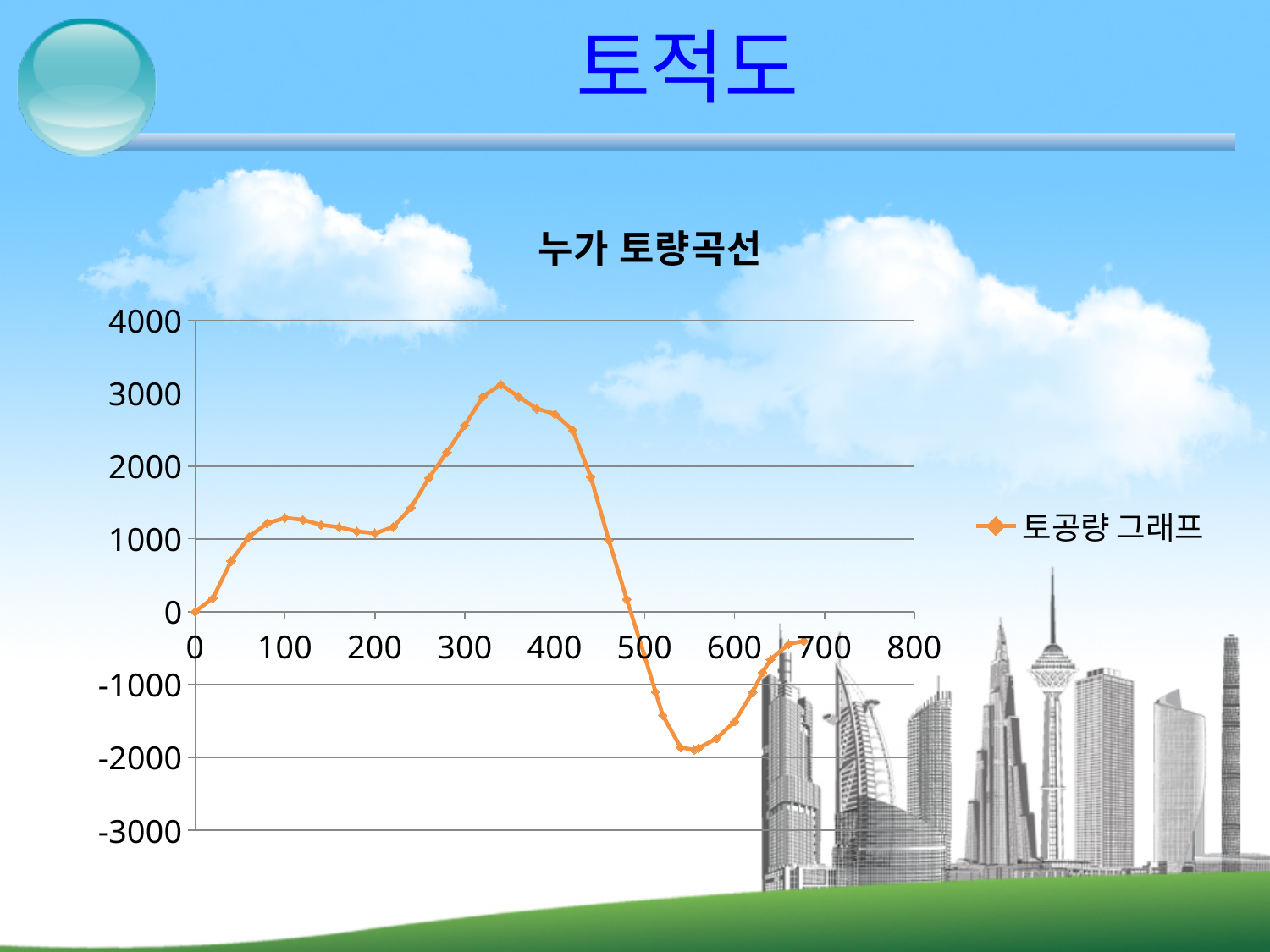
Is the value of the 토공량 그래프 series at x = 600 greater or less than -1000? less Is the value of the 토공량 그래프 series at x = 300 greater or less than 2000? greater What is the value of the 토공량 그래프 series at x = 0? 0 What kind of chart is shown on the slide? line chart Does the 토공량 그래프 series rise or fall between x = 400 and x = 550? fall What is the title of the chart? 누가 토량곡선 How many series does the legend list? 1 What is the name of the series shown in the legend? 토공량 그래프 Which is larger, the value of the 토공량 그래프 series at x = 100 or at x = 300? x = 300 Is the lowest value of the 토공량 그래프 series greater or less than -1000? less